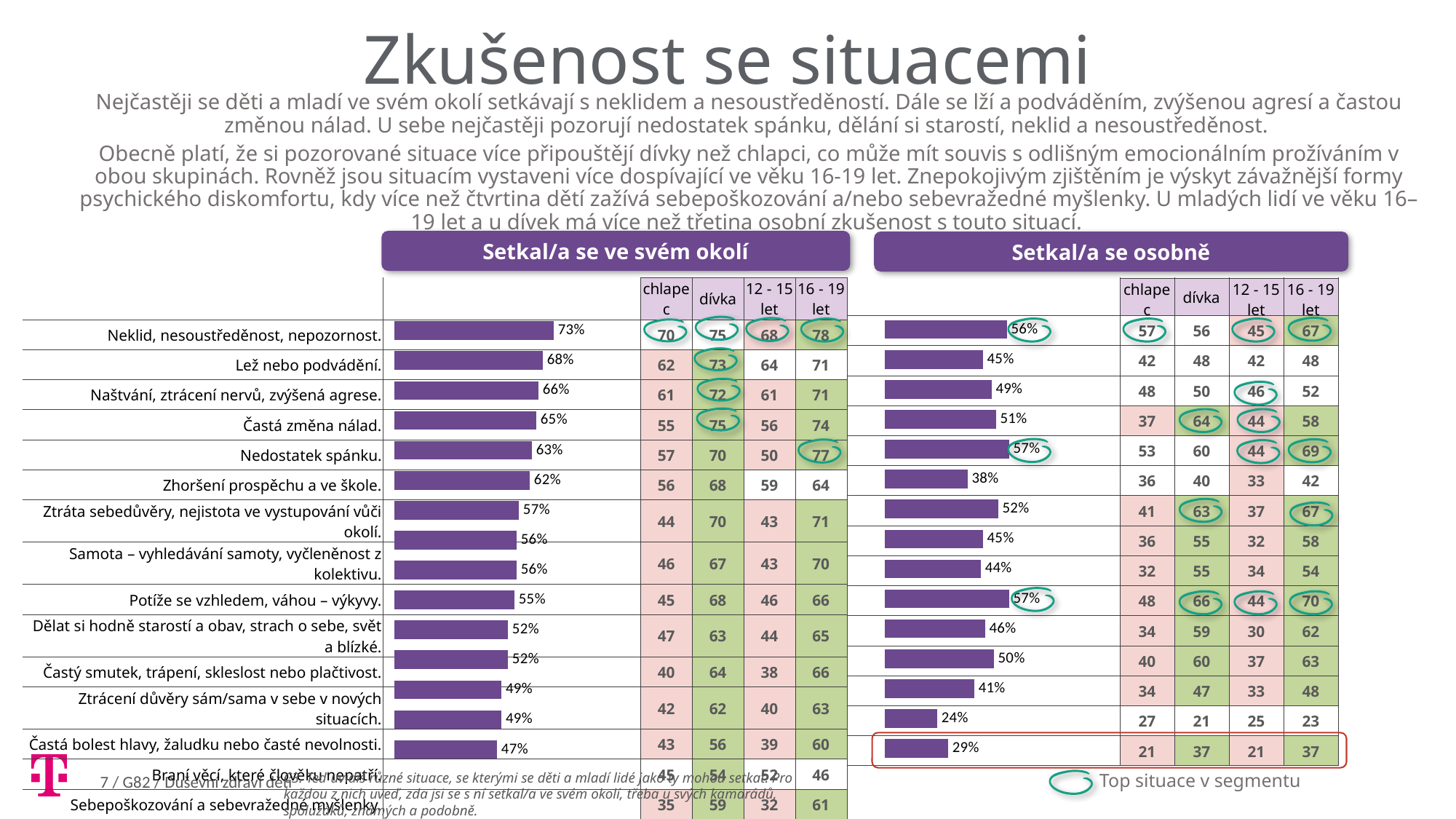
In the 'Setkal/a se osobně' chart, what is the lowest value shown? 24% What kind of chart is used on the slide for 'Setkal/a se ve svém okolí'? bar chart In the 'Setkal/a se ve svém okolí' chart, which category has the highest value? Neklid, nesoustředěnost, nepozornost Which is larger: 'Častá změna nálad' in the 'Setkal/a se ve svém okolí' chart or in the 'Setkal/a se osobně' chart? Setkal/a se ve svém okolí In the 'Setkal/a se ve svém okolí' chart, what is the value for 'Neklid, nesoustředěnost, nepozornost'? 73% In the 'Setkal/a se ve svém okolí' chart, what is the difference between 'Neklid, nesoustředěnost, nepozornost' and 'Lež nebo podvádění'? 5% In the 'Setkal/a se ve svém okolí' chart, what is the lowest value shown? 47% In the 'Setkal/a se ve svém okolí' chart, what is the value for 'Nedostatek spánku'? 63% In the 'Setkal/a se osobně' chart, what is the value for 'Neklid, nesoustředěnost, nepozornost'? 56% In the 'Setkal/a se ve svém okolí' chart, what is the value for 'Lež nebo podvádění'? 68% How many bars does the 'Setkal/a se osobně' chart contain? 15 In the 'Setkal/a se osobně' chart, what is the value for 'Zhoršení prospěchu a ve škole'? 38%